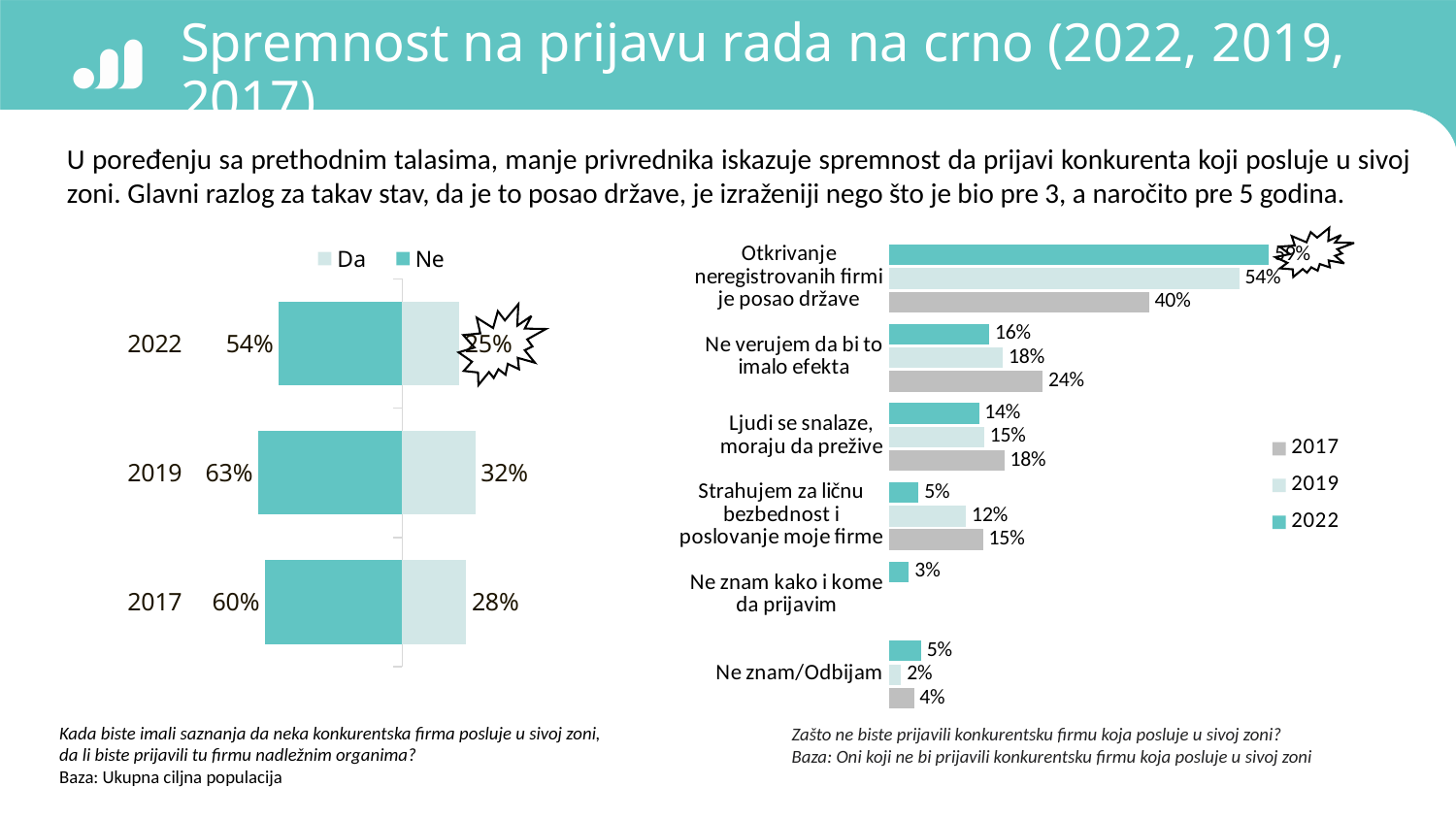
On the left chart, what is the 'Ne' value for 2022? 54% On the right chart, which is larger for 'Ljudi se snalaze, moraju da prežive': the 2017 value or the 2022 value? 2017 What type of chart is the right chart? Bar chart On the right chart, how many series does the legend list? 3 On the left chart, what is the 'Da' value for 2017? 28% On the right chart, what is the difference between the 2017 and 2022 values for 'Ne verujem da bi to imalo efekta'? 8% On the right chart, what is the 2019 value for 'Strahujem za ličnu bezbednost i poslovanje moje firme'? 12% On the right chart, what is the 2022 value for 'Ne verujem da bi to imalo efekta'? 16% On the left chart, what is the 'Ne' value for 2019? 63% On the right chart, what is the 2017 value for 'Otkrivanje neregistrovanih firmi je posao države'? 40% On the left chart, what is the difference between the 'Ne' values for 2019 and 2017? 3% On the left chart, how many series does the legend list? 2